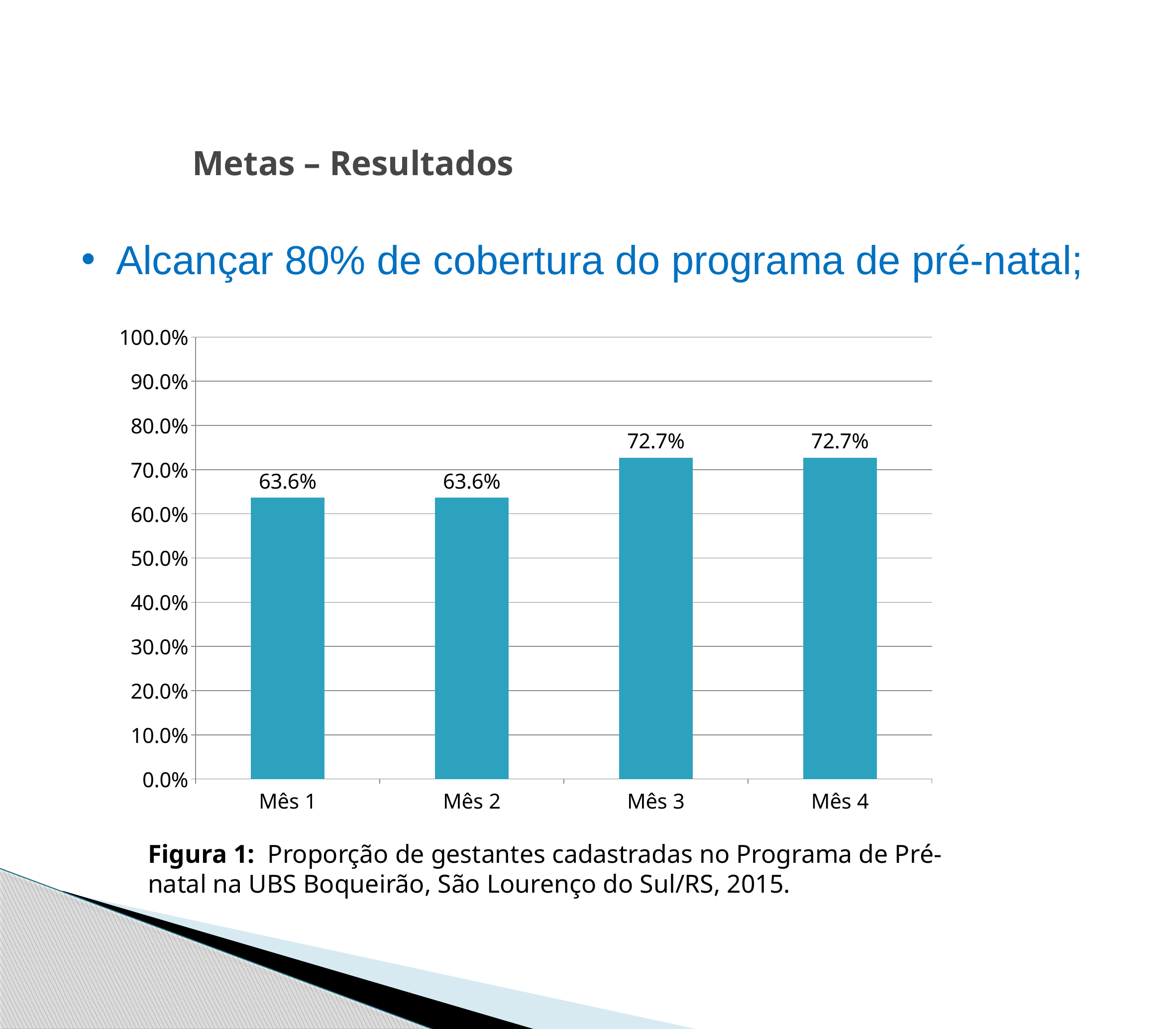
What colour are the bars in the chart? blue Which is larger, the value for Mês 1 or the value for Mês 4? Mês 4 What is the difference between the values for Mês 3 and Mês 2? 9.1% Is the value for Mês 2 greater or less than 70.0%? less How many categories are shown on the x axis? 4 What is the value for Mês 1? 63.6% What is the value for Mês 4? 72.7% Do the values rise or fall from Mês 1 to Mês 4? rise What is the value for Mês 3? 72.7% What kind of chart is shown on the slide? bar chart What is the highest value shown on the y axis? 100.0% Is the value for Mês 3 greater or less than 80.0%? less